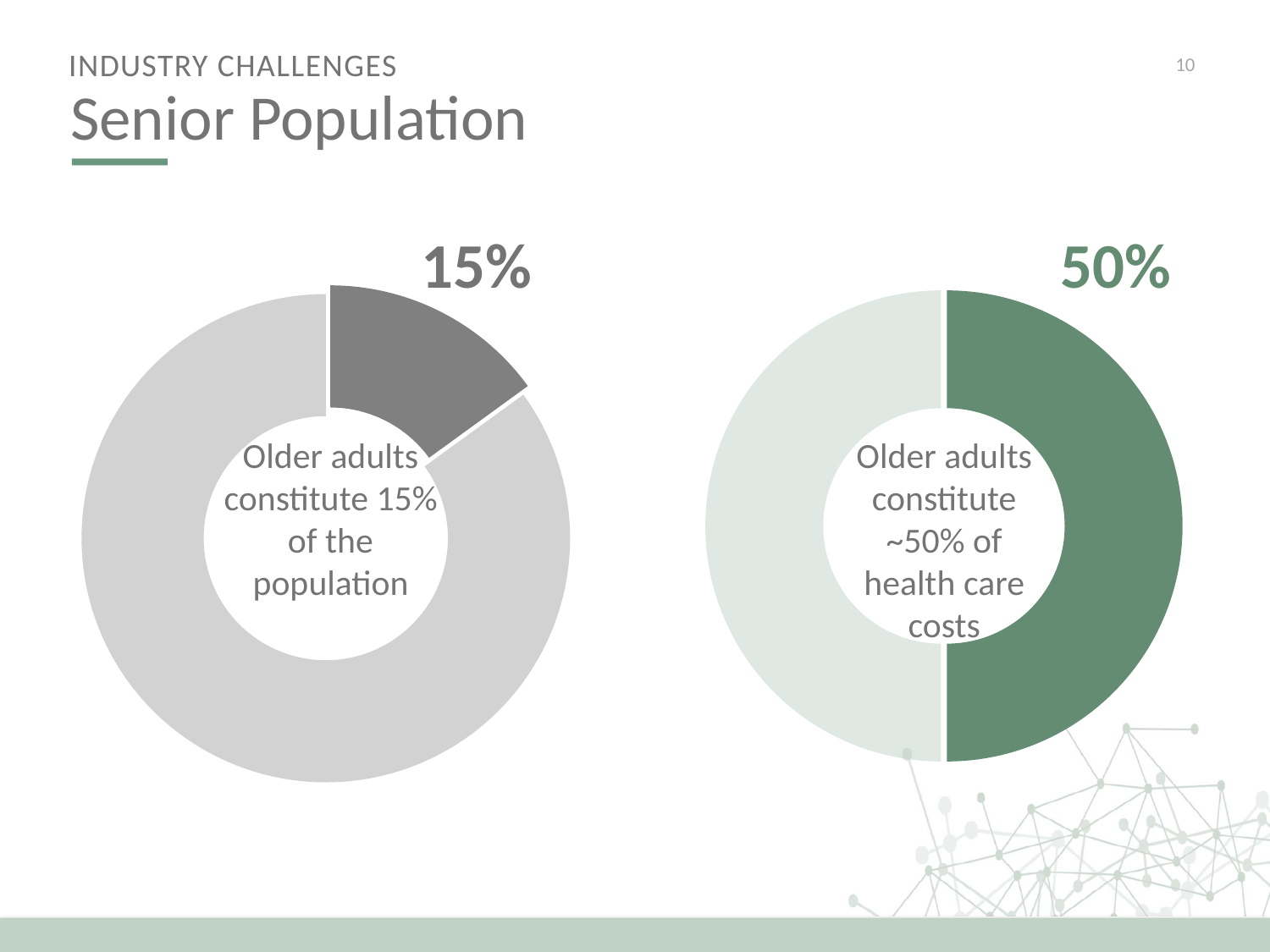
How many slices does the right donut chart have? 2 In the left chart, what percentage of the population do older adults constitute? 15% What kind of chart is the left chart on the slide? Donut chart What is the title of the slide containing the two donut charts? Senior Population What kind of chart is the right chart on the slide? Donut chart Which is larger: the highlighted share in the left chart or the highlighted share in the right chart? The right chart (50%) In the right chart, what share of the donut does the dark green slice represent? 50% How many slices does the left donut chart have? 2 In the right chart, what share of health care costs do older adults constitute? 50% In the left chart, is the highlighted dark grey slice greater or less than 50% of the donut? less What colour is the highlighted 50% slice in the right chart? Green